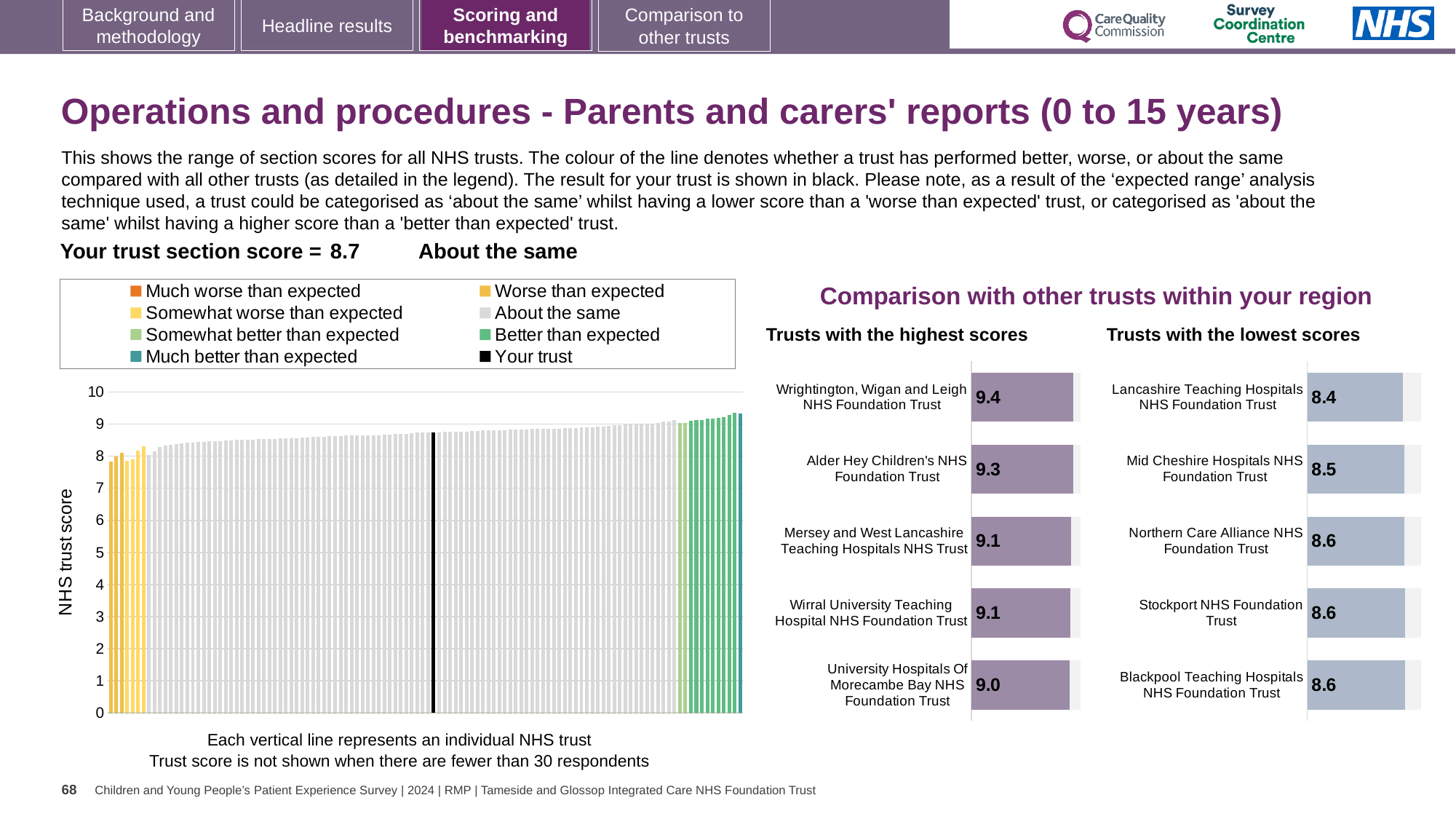
In the 'Trusts with the highest scores' chart, which trust has the highest score? Wrightington, Wigan and Leigh NHS Foundation Trust In the 'Trusts with the highest scores' chart, what is the score for Wrightington, Wigan and Leigh NHS Foundation Trust? 9.4 What kind of chart is the large chart on the left showing NHS trust scores? Bar chart How many trusts are listed in the 'Trusts with the highest scores' chart? 5 How many entries does the legend of the left-hand chart list? 8 In the 'Trusts with the lowest scores' chart, what is the score for Stockport NHS Foundation Trust? 8.6 In the 'Trusts with the lowest scores' chart, which trust has the lowest score? Lancashire Teaching Hospitals NHS Foundation Trust In the left-hand chart, is the value for your trust (the black line) greater or less than 8? greater In the 'Trusts with the highest scores' chart, which has the higher score: Alder Hey Children's NHS Foundation Trust or University Hospitals Of Morecambe Bay NHS Foundation Trust? Alder Hey Children's NHS Foundation Trust In the 'Trusts with the lowest scores' chart, what is the difference between the scores of Mid Cheshire Hospitals NHS Foundation Trust and Lancashire Teaching Hospitals NHS Foundation Trust? 0.1 In the 'Trusts with the lowest scores' chart, what is the score for Lancashire Teaching Hospitals NHS Foundation Trust? 8.4 In the 'Trusts with the highest scores' chart, what is the difference between the scores of Wrightington, Wigan and Leigh NHS Foundation Trust and Alder Hey Children's NHS Foundation Trust? 0.1